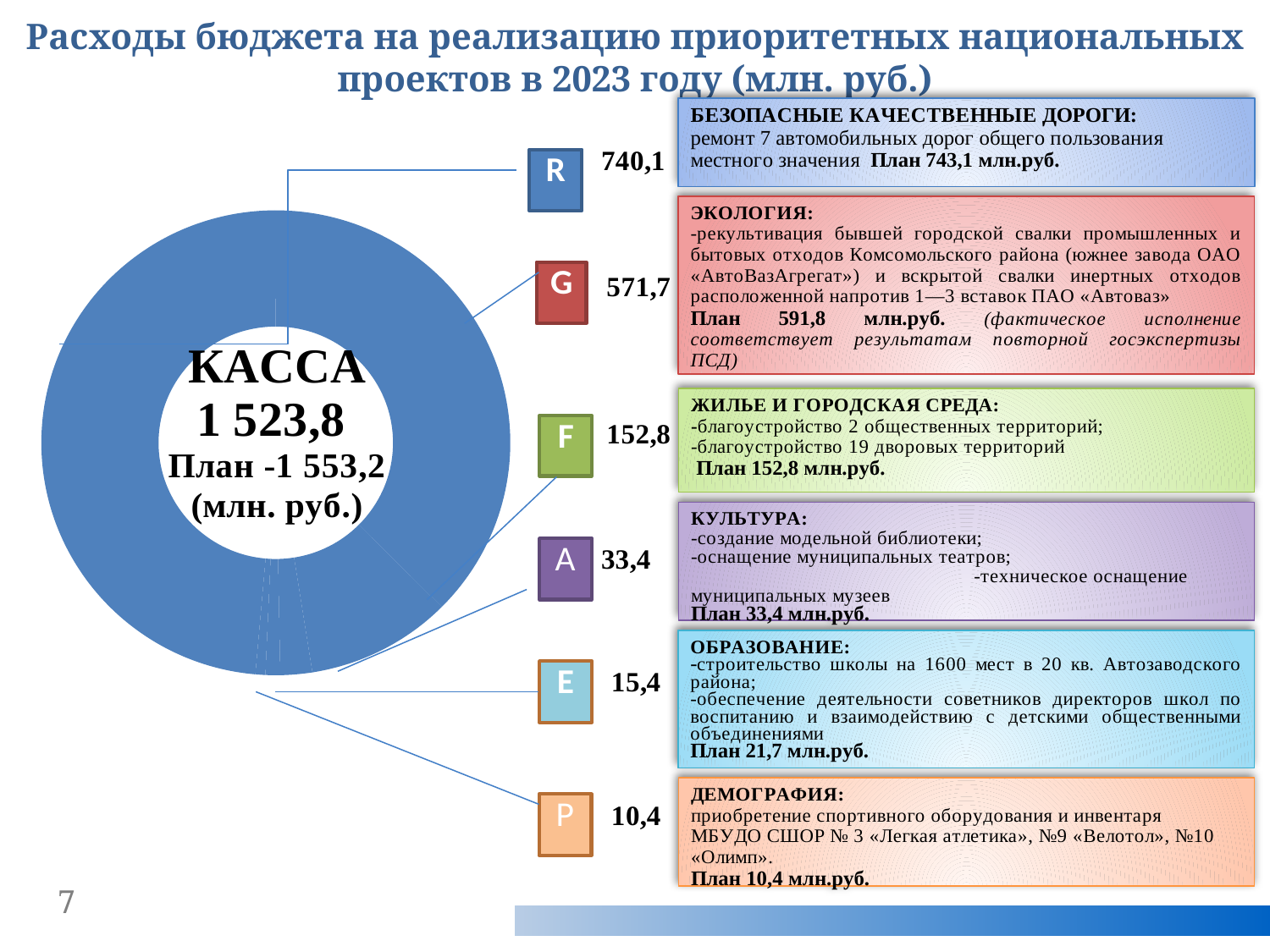
How many national projects (segments) are shown in the chart? 6 What is the value shown for the Экология (G) segment? 571,7 What is the value shown for the Безопасные качественные дороги (R) segment? 740,1 Which national project has the highest expenditure in the chart? Безопасные качественные дороги What total (КАССА) is shown in the centre of the chart? 1 523,8 What is the value shown for the Жилье и городская среда (F) segment? 152,8 Which is larger, the value for Образование (E) or the value for Демография (P)? Образование (E) What is the value shown for the Культура (A) segment? 33,4 What kind of chart is shown on the slide? doughnut chart What is the difference between the values for Безопасные качественные дороги and Экология? 168,4 Which national project has the lowest expenditure in the chart? Демография What is the value shown for the Демография (P) segment? 10,4